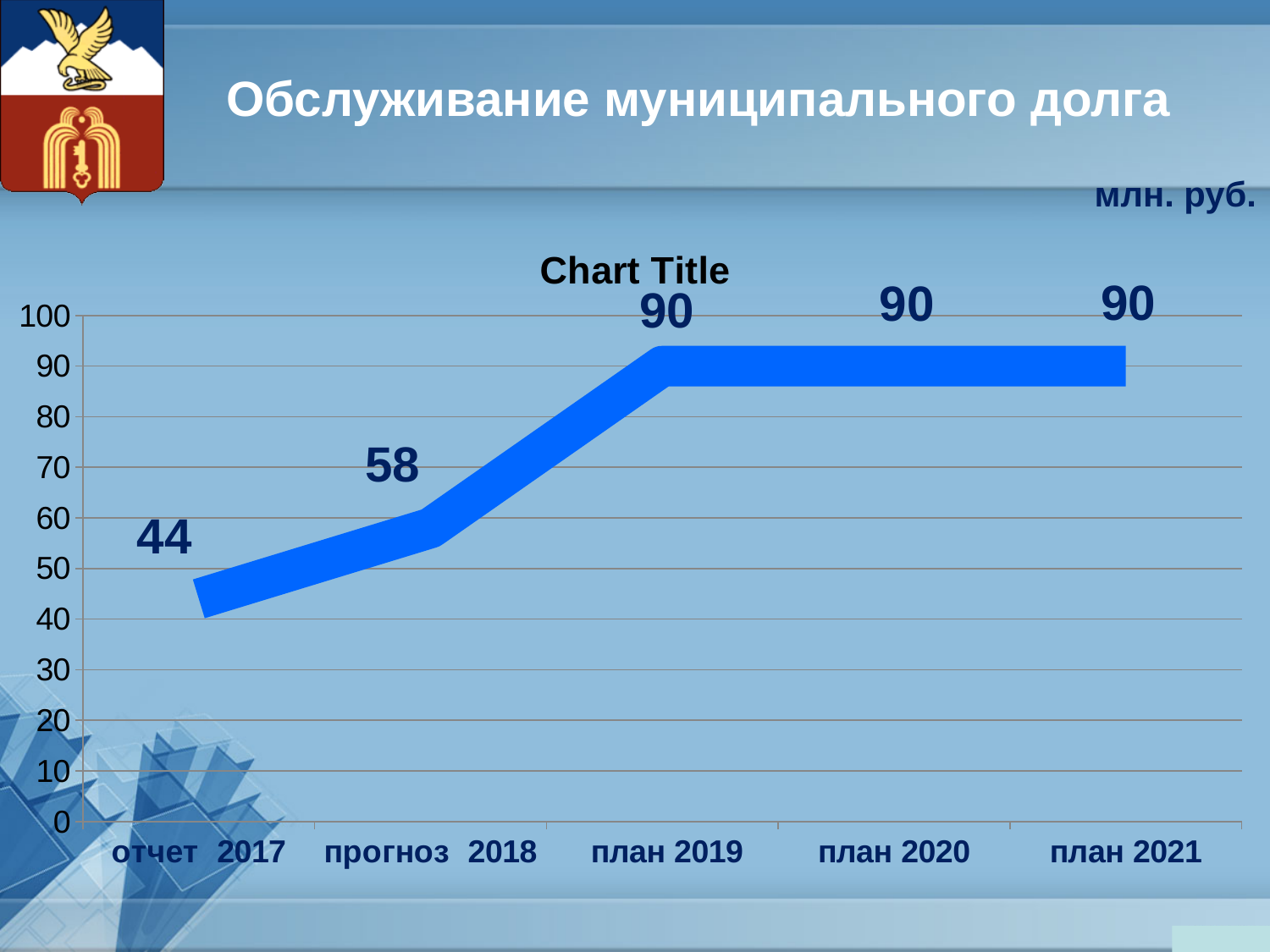
Which category has the lowest value? отчет 2017 Is the value for отчет 2017 greater or less than 50? less What is the value for план 2019? 90 What kind of chart is shown on the slide? line chart What is the value for план 2021? 90 How many categories are shown on the x axis? 5 What is the difference between the values for прогноз 2018 and отчет 2017? 14 What is the value for отчет 2017? 44 What is the value for прогноз 2018? 58 What is the difference between the values for план 2019 and прогноз 2018? 32 Which is larger, the value for прогноз 2018 or the value for план 2020? план 2020 Do the values rise or fall from отчет 2017 to план 2019? rise